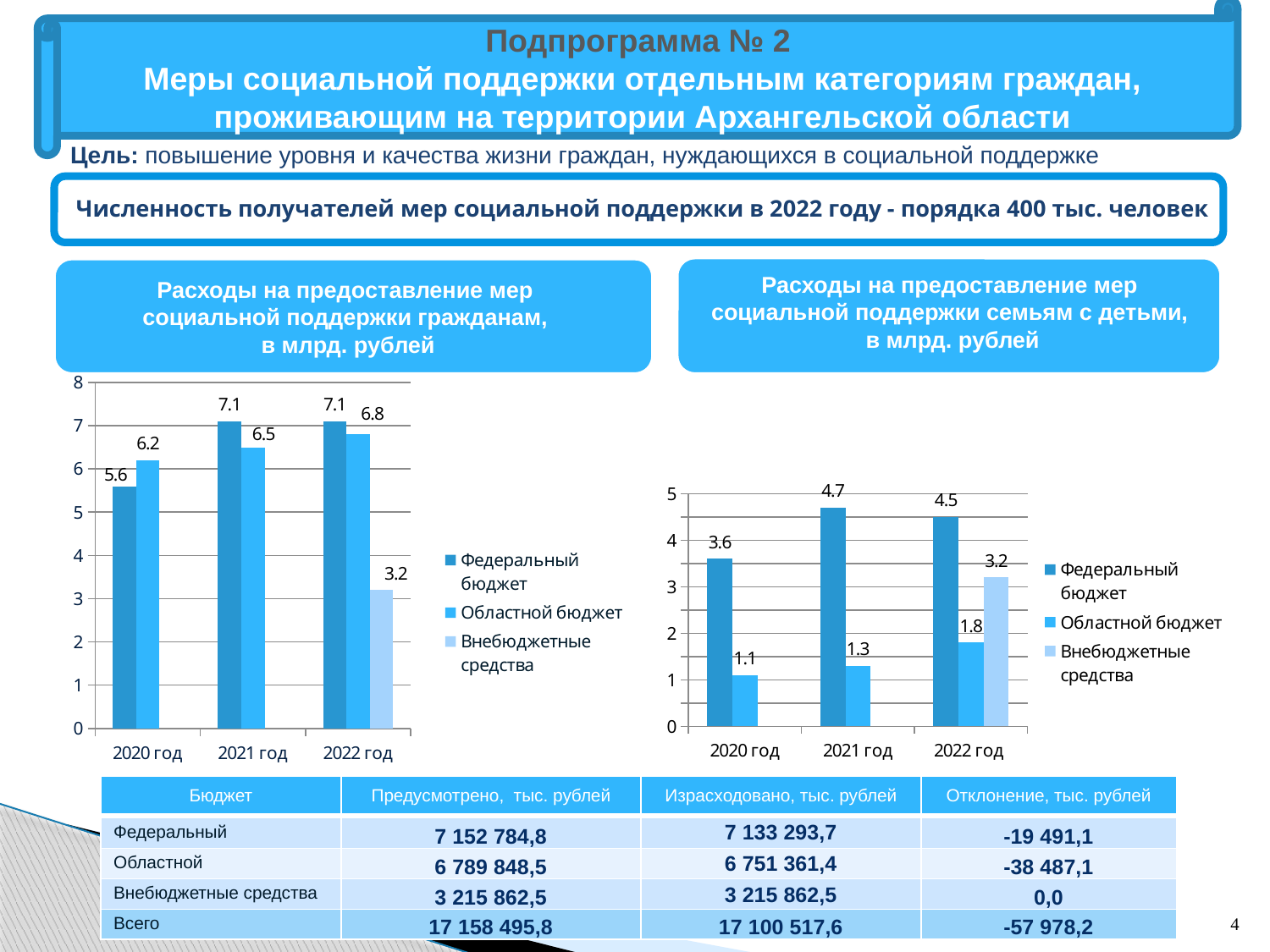
In the left chart (expenses on social support measures for citizens), does the Областной бюджет series rise or fall from 2020 год to 2022 год? rise In the right chart (expenses on social support measures for families with children), which year has the highest value for Федеральный бюджет? 2021 год In the right chart (expenses on social support measures for families with children), which is larger in 2022 год: Федеральный бюджет or Внебюджетные средства? Федеральный бюджет In the left chart (expenses on social support measures for citizens), what is the value for Областной бюджет in 2022 год? 6.8 In the left chart (expenses on social support measures for citizens), how many series does the legend list? 3 In the right chart (expenses on social support measures for families with children), what is the value for Областной бюджет in 2020 год? 1.1 In the left chart (expenses on social support measures for citizens), what is the value for Федеральный бюджет in 2020 год? 5.6 In the left chart (expenses on social support measures for citizens), what is the value for Внебюджетные средства in 2022 год? 3.2 What type of chart is the right chart (expenses on social support measures for families with children)? bar chart In the left chart (expenses on social support measures for citizens), what is the difference between Областной бюджет in 2022 год and 2020 год? 0.6 In the right chart (expenses on social support measures for families with children), what is the value for Федеральный бюджет in 2021 год? 4.7 In the right chart (expenses on social support measures for families with children), which year has the lowest value for Областной бюджет? 2020 год